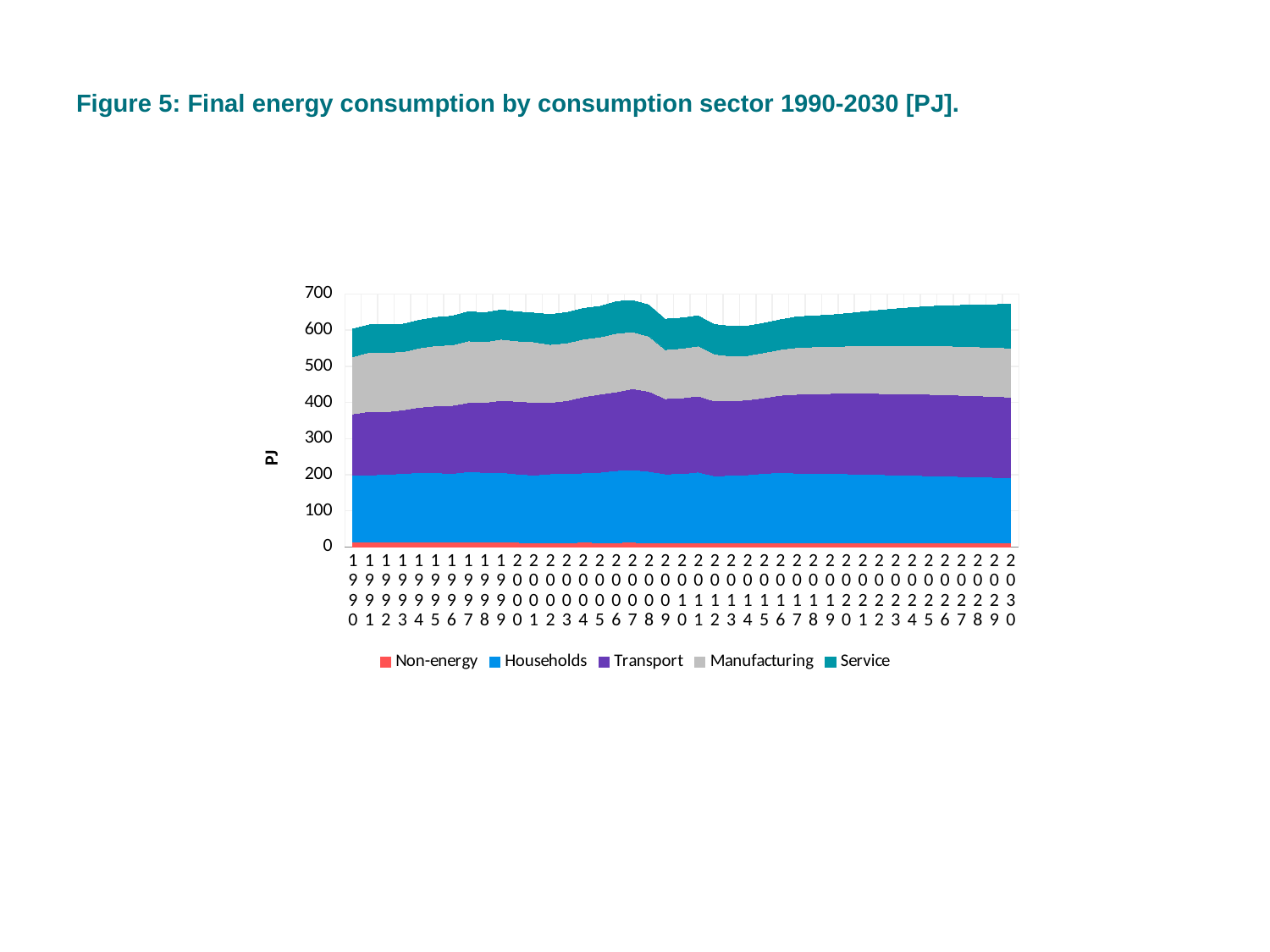
Which is larger in 1990: the Households band or the Non-energy band? Households What is the title of the chart? Figure 5: Final energy consumption by consumption sector 1990-2030 [PJ]. What label is shown on the y axis? PJ What kind of chart is shown on the slide? Stacked area chart In 2030, which is larger: the Transport band or the Service band? Transport Is the total final energy consumption in 2030 greater or less than 600? greater How many years are plotted along the x axis? 41 Which series is the smallest band in the stacked area chart? Non-energy Is the total final energy consumption in 2010 greater or less than 700? less Is the total final energy consumption in 2007 greater or less than 600? greater How many series does the legend list? 5